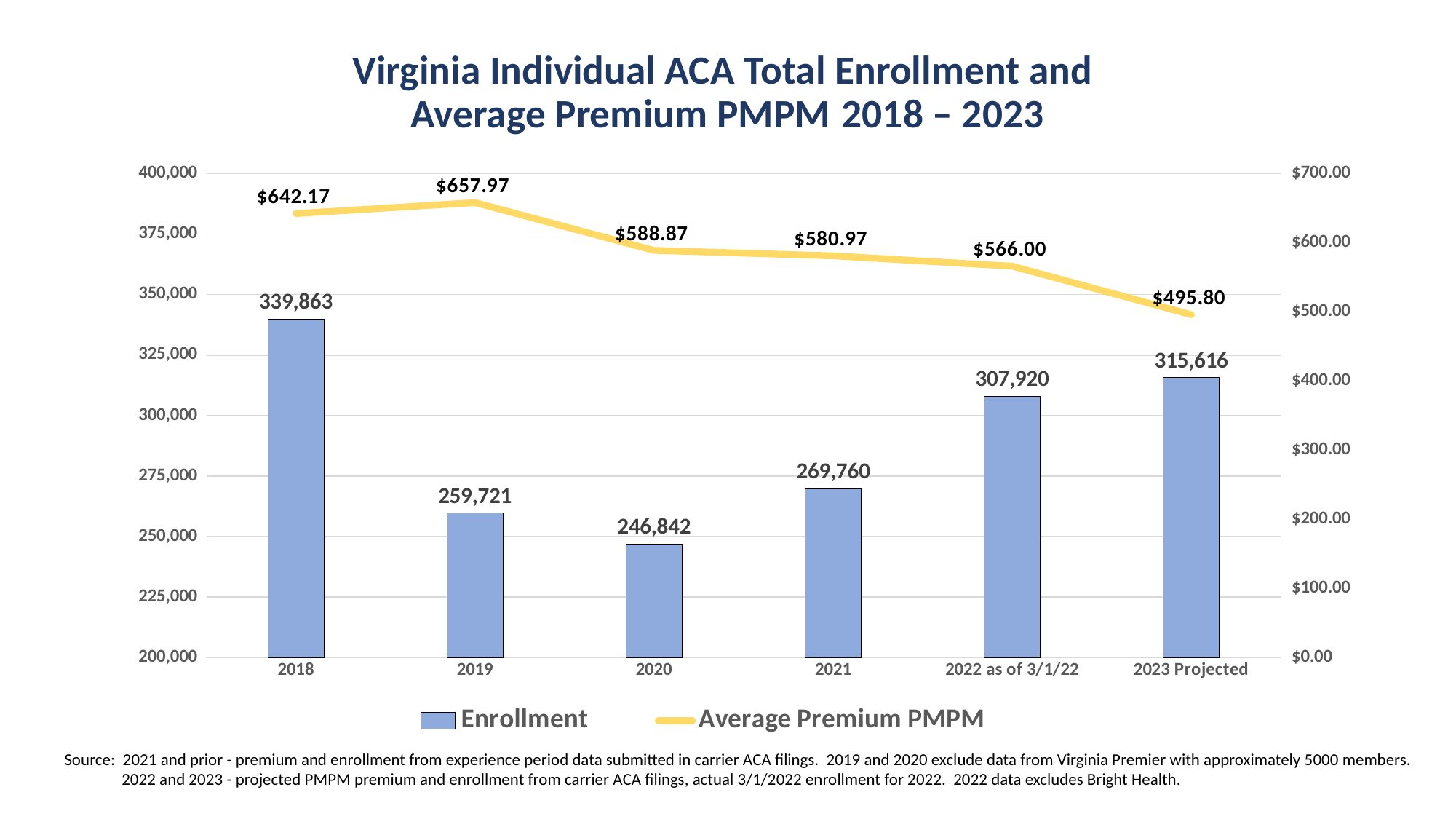
How many years (categories) are shown on the x axis? 6 What is the projected Enrollment for 2023? 315,616 Does the Average Premium PMPM rise or fall from 2019 to 2023 Projected? fall Which year has the highest Average Premium PMPM? 2019 What was the Enrollment in 2018? 339,863 What colour is the Average Premium PMPM line? yellow How many series does the legend list? 2 What is the difference in Average Premium PMPM between 2022 as of 3/1/22 and 2023 Projected? $70.20 Which year has the lowest Enrollment? 2020 What was the Average Premium PMPM in 2020? $588.87 Which is larger, the Enrollment in 2021 or in 2019? 2021 What is the difference in Enrollment between 2018 and 2020? 93,021